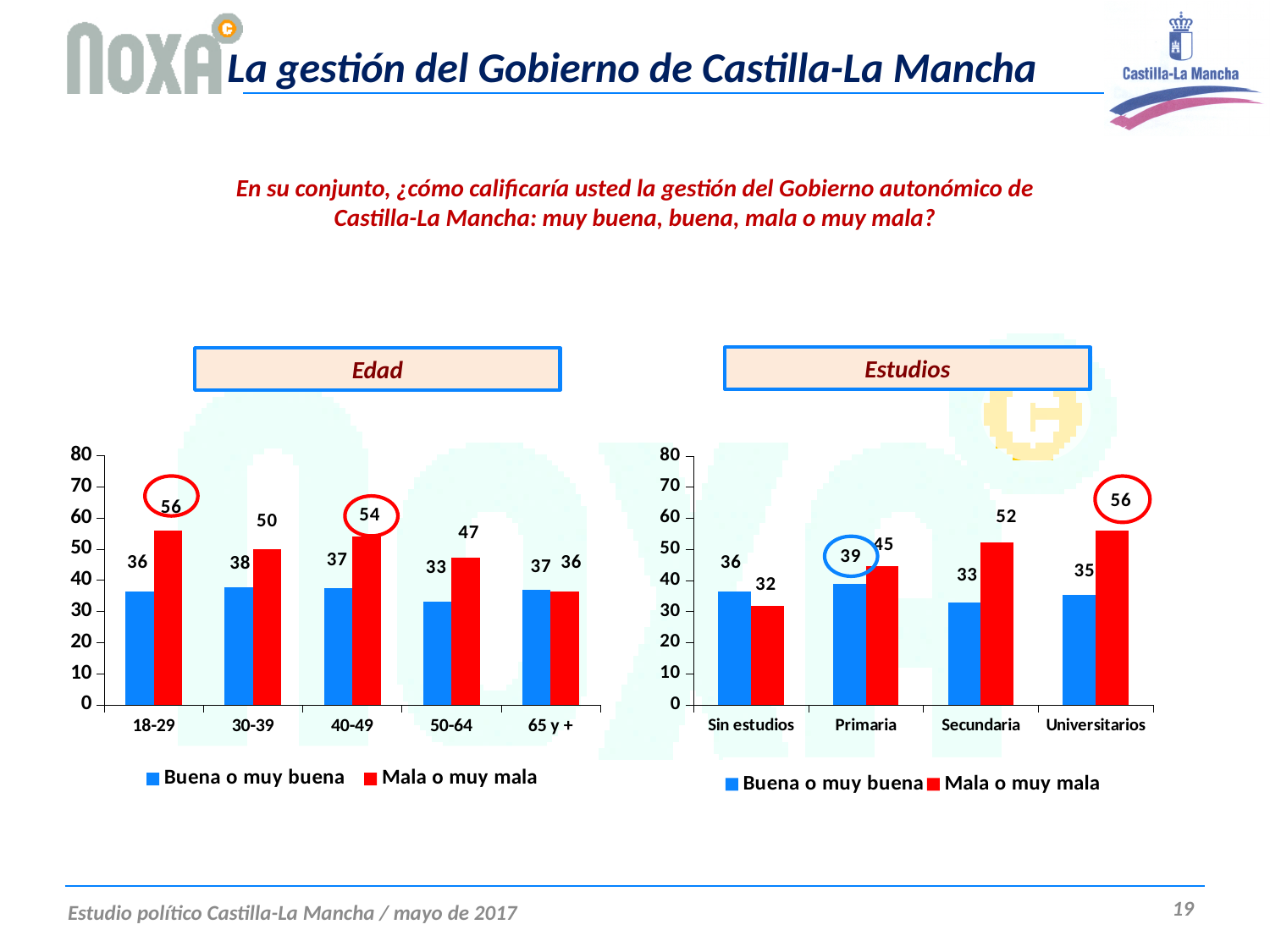
In the Estudios chart, which is larger for Secundaria: Buena o muy buena or Mala o muy mala? Mala o muy mala In the Edad chart, what is the difference between Mala o muy mala and Buena o muy buena for the 40-49 group? 17 In the Estudios chart, what is the value of Buena o muy buena for Primaria? 39 In the Estudios chart, what is the value of Mala o muy mala for Universitarios? 56 In the Edad chart, how many age groups are shown on the x axis? 5 In the Edad chart, which age group has the highest Mala o muy mala value? 18-29 In the Edad chart, what is the value of Mala o muy mala for the 18-29 group? 56 In the Edad chart, which age group has the lowest Buena o muy buena value? 50-64 What kind of chart is the Estudios chart? Bar chart In the Estudios chart, how many series does the legend list? 2 In the Edad chart, what is the value of Buena o muy buena for the 50-64 group? 33 In the Estudios chart, which education level has the lowest Mala o muy mala value? Sin estudios